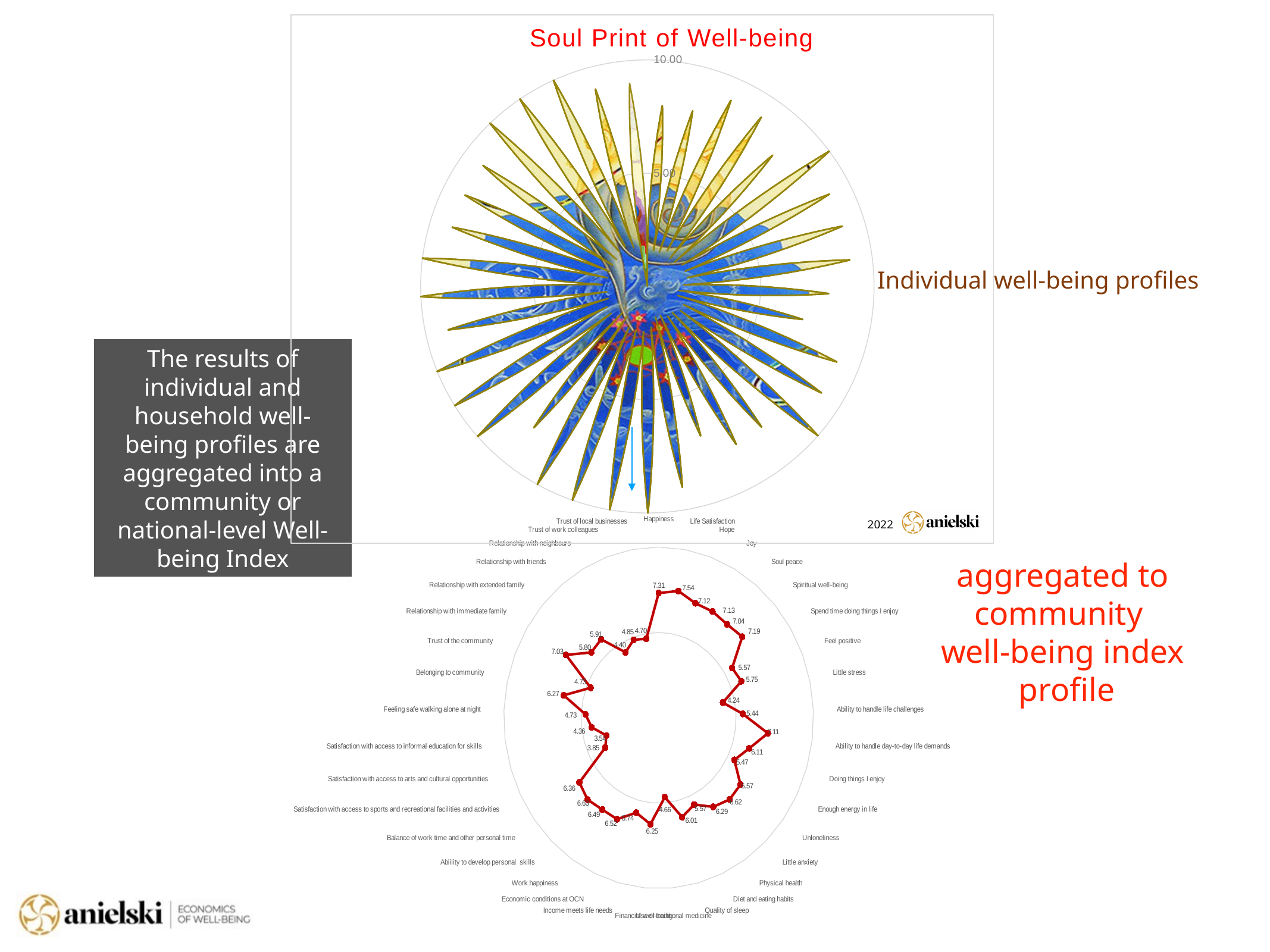
In the bottom chart (community well-being index profile), what is the value for Little stress? 4.24 In the bottom chart (community well-being index profile), which category has the highest value? Life Satisfaction In the bottom chart (community well-being index profile), which is larger: the value for Happiness or the value for Life Satisfaction? Life Satisfaction In the bottom chart (community well-being index profile), which is larger: the value for Little stress or the value for Relationship with immediate family? Relationship with immediate family In the bottom chart (community well-being index profile), what is the value for Life Satisfaction? 7.54 In the bottom chart (community well-being index profile), what is the value for Happiness? 7.31 In the bottom chart (community well-being index profile), what is the value for Relationship with immediate family? 7.03 In the bottom chart (community well-being index profile), what is the difference between the values for Life Satisfaction and Happiness? 0.23 What is the title of the top chart? Soul Print of Well-being In the top chart (Soul Print of Well-being), what is the maximum value shown on the radial axis? 10.00 What kind of chart is the bottom chart (the community well-being index profile)? radar chart In the bottom chart (community well-being index profile), which category has the lowest value? Satisfaction with access to arts and cultural opportunities